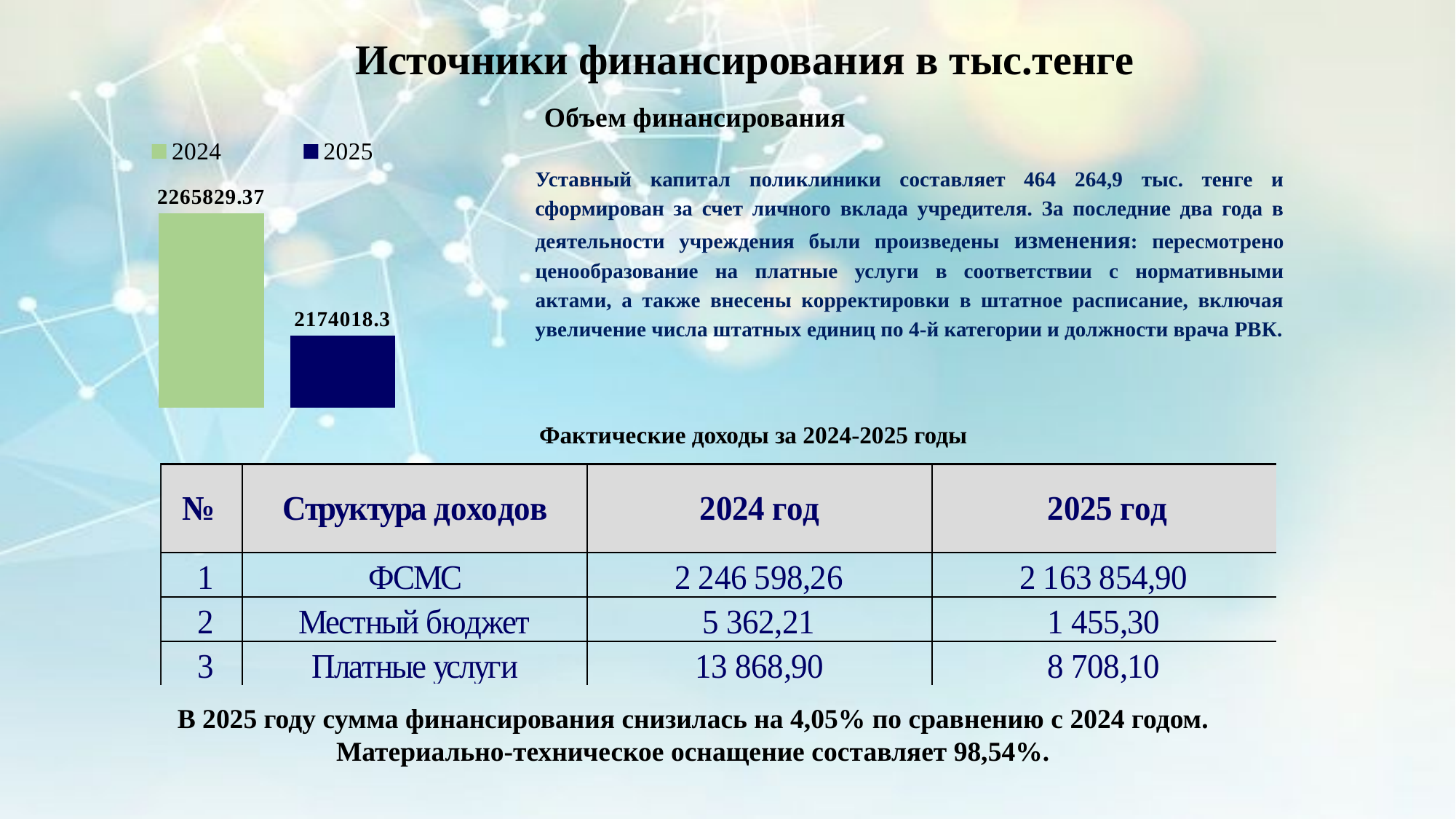
How many bars are plotted in the chart? 2 Which year has the higher bar in the chart? 2024 What is the value of the 2025 bar in the chart? 2174018.3 What is the value of the 2024 bar in the chart? 2265829.37 Which colour represents 2025 in the chart legend? dark blue By how much does the 2024 bar exceed the 2025 bar? 91811.07 How many entries does the chart legend list? 2 Which year has the lower bar in the chart? 2025 Do the values rise or fall from 2024 to 2025 in the chart? fall What is the title of the chart? Объем финансирования Is the value for 2025 larger or smaller than the value for 2024? smaller What type of chart is shown on the slide? bar chart